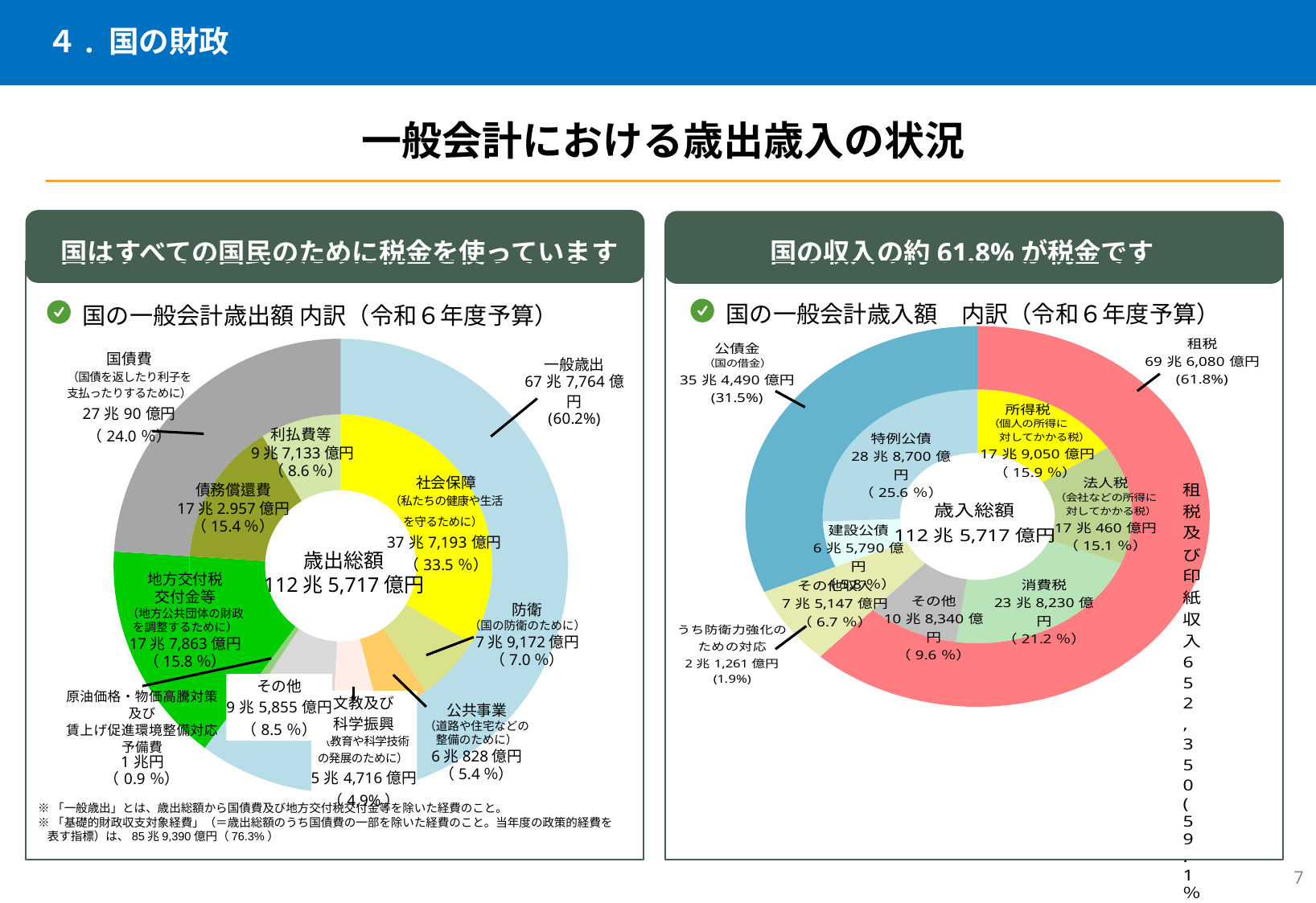
On the right chart (国の一般会計歳入額 内訳), what is the value shown for 消費税? 23兆8,230億円 On the right chart (国の一般会計歳入額 内訳), what percentage of revenue is 公債金? 31.5% On the left chart (国の一般会計歳出額 内訳), what is the difference in percentage points between 地方交付税交付金等 (15.8%) and 債務償還費 (15.4%)? 0.4 percentage points According to the header above the right chart, approximately what percentage of the national revenue is tax? 61.8% On the right chart (国の一般会計歳入額 内訳), which tax item has the largest share: 所得税, 法人税 or 消費税? 消費税 On the left chart (国の一般会計歳出額 内訳), what is the 歳出総額 shown in the centre of the donut? 112兆5,717億円 On the right chart (国の一般会計歳入額 内訳), what is the difference between 特例公債 (25.6%) and 建設公債 (5.8%) in percentage points? 19.8 percentage points What kind of chart is used on the left side of the slide to show the 歳出 breakdown? Donut (pie) chart On the left chart (国の一般会計歳出額 内訳), which is larger, 防衛 or 公共事業? 防衛 On the right chart (国の一般会計歳入額 内訳), which is smaller, 建設公債 or その他収入? 建設公債 On the left chart (国の一般会計歳出額 内訳), what is the value shown for 社会保障? 37兆7,193億円 On the left chart (国の一般会計歳出額 内訳), what percentage is shown for 国債費? 24.0%